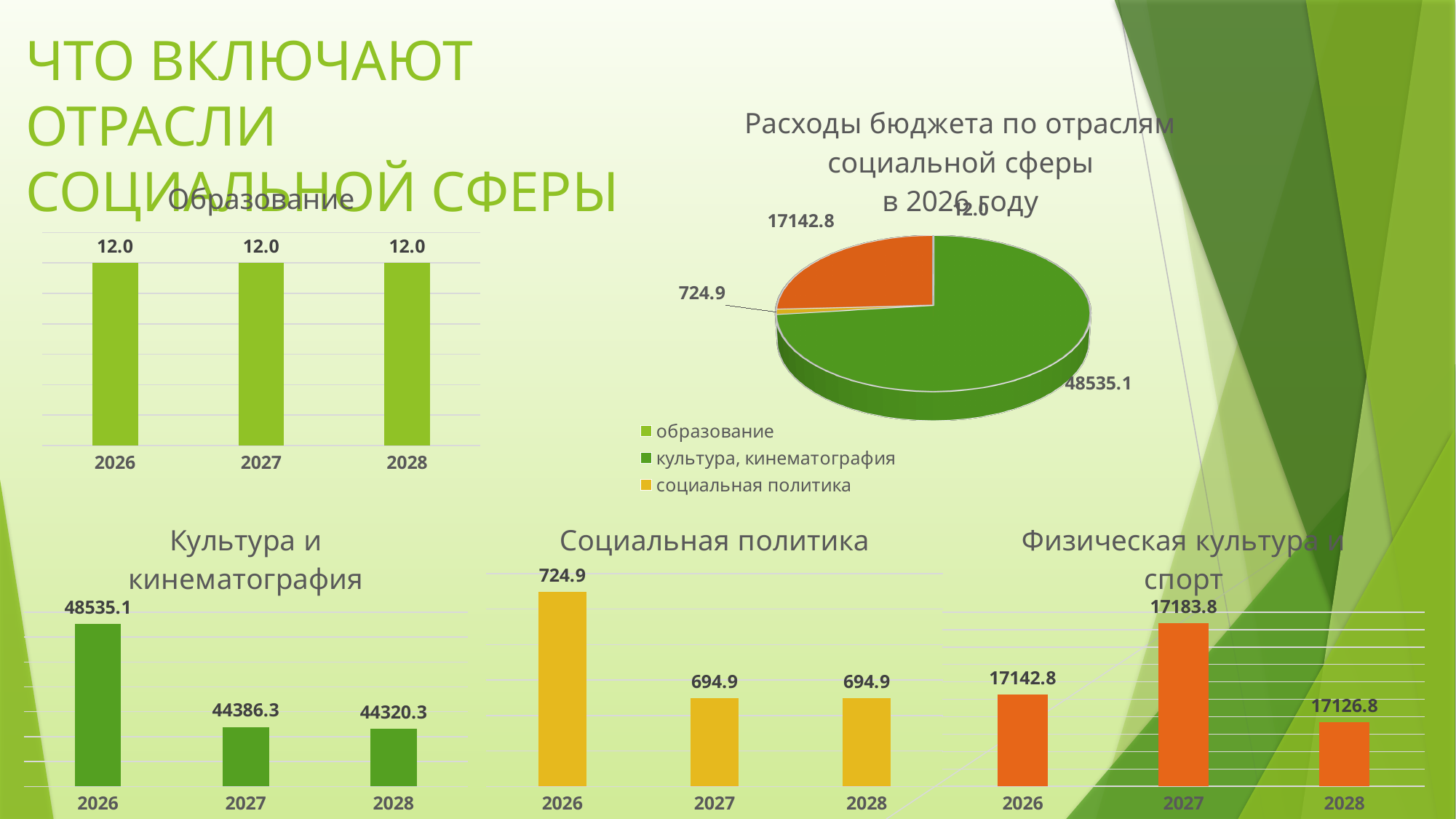
In the 'Культура и кинематография' chart, what is the difference between the 2026 and 2027 values? 4148.8 What kind of chart is 'Расходы бюджета по отраслям социальной сферы в 2026 году'? pie chart In the 'Социальная политика' chart, what is the value for 2028? 694.9 How many entries does the legend of the pie chart 'Расходы бюджета по отраслям социальной сферы в 2026 году' list? 3 In the 'Физическая культура и спорт' chart, what is the value for 2027? 17183.8 In the 'Культура и кинематография' chart, what is the value for 2026? 48535.1 In the 'Образование' chart, what is the value for 2027? 12.0 In the 'Культура и кинематография' chart, which year has the highest value? 2026 In the 'Социальная политика' chart, do the values rise or fall from 2026 to 2027? fall In the 'Физическая культура и спорт' chart, which year has the lowest value? 2028 In the 'Физическая культура и спорт' chart, is the value for 2026 larger or smaller than the value for 2027? smaller How many bars does the 'Образование' chart show? 3